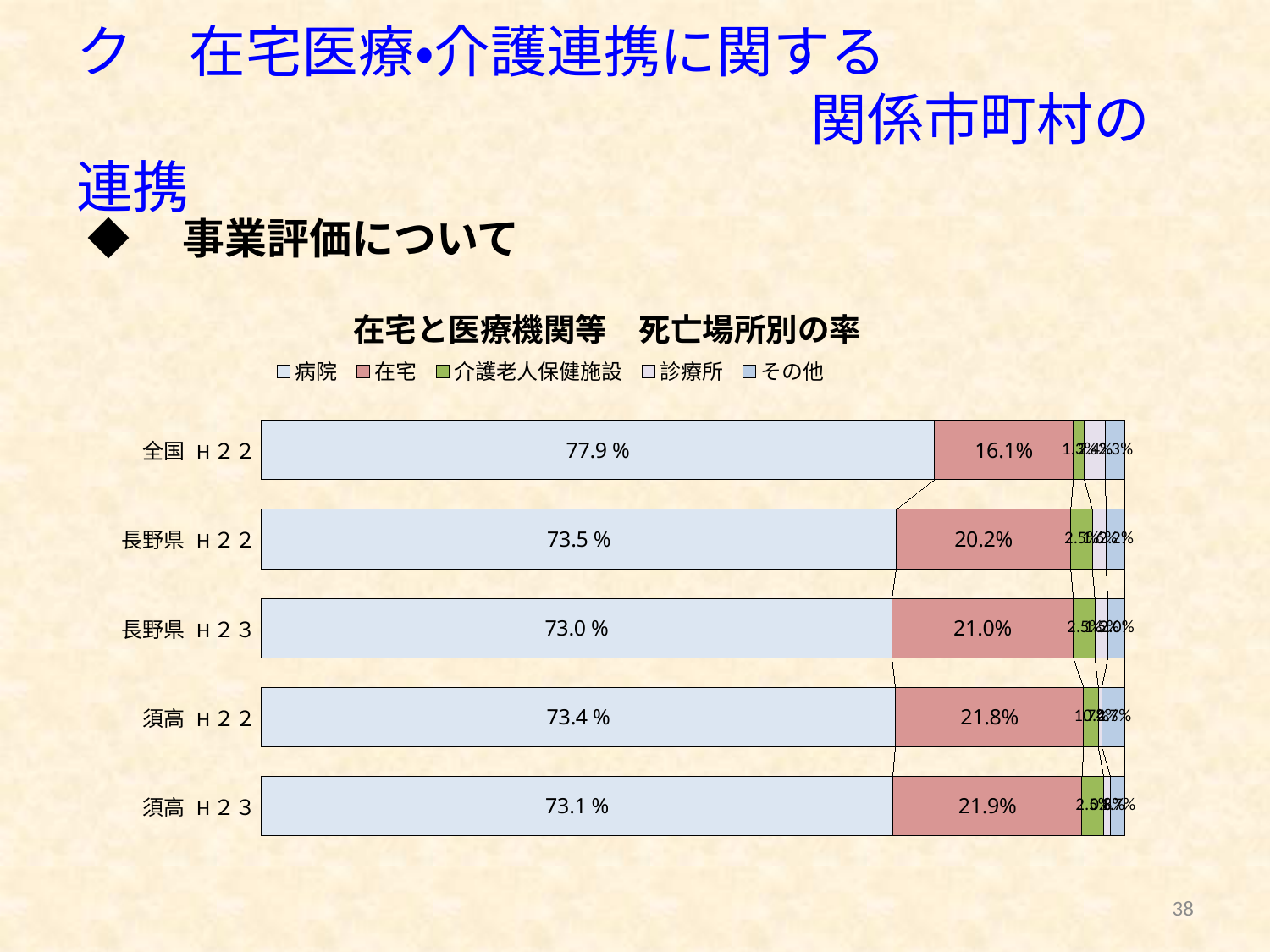
What is the 在宅 value for 長野県 H22? 20.2% What kind of chart is shown on the slide? Stacked bar chart What is the 病院 value for 長野県 H23? 73.0 % Which category has the highest 病院 value? 全国 H22 How many categories are shown on the chart? 5 Which category has the lowest 在宅 value? 全国 H22 Which is larger, the 病院 value for 長野県 H22 or for 須高 H22? 長野県 H22 How many series does the legend list? 5 What is the title of the chart? 在宅と医療機関等 死亡場所別の率 What is the 病院 value for 全国 H22? 77.9 % What is the 在宅 value for 須高 H23? 21.9% What is the difference between the 在宅 values for 須高 H22 and 全国 H22? 5.7%